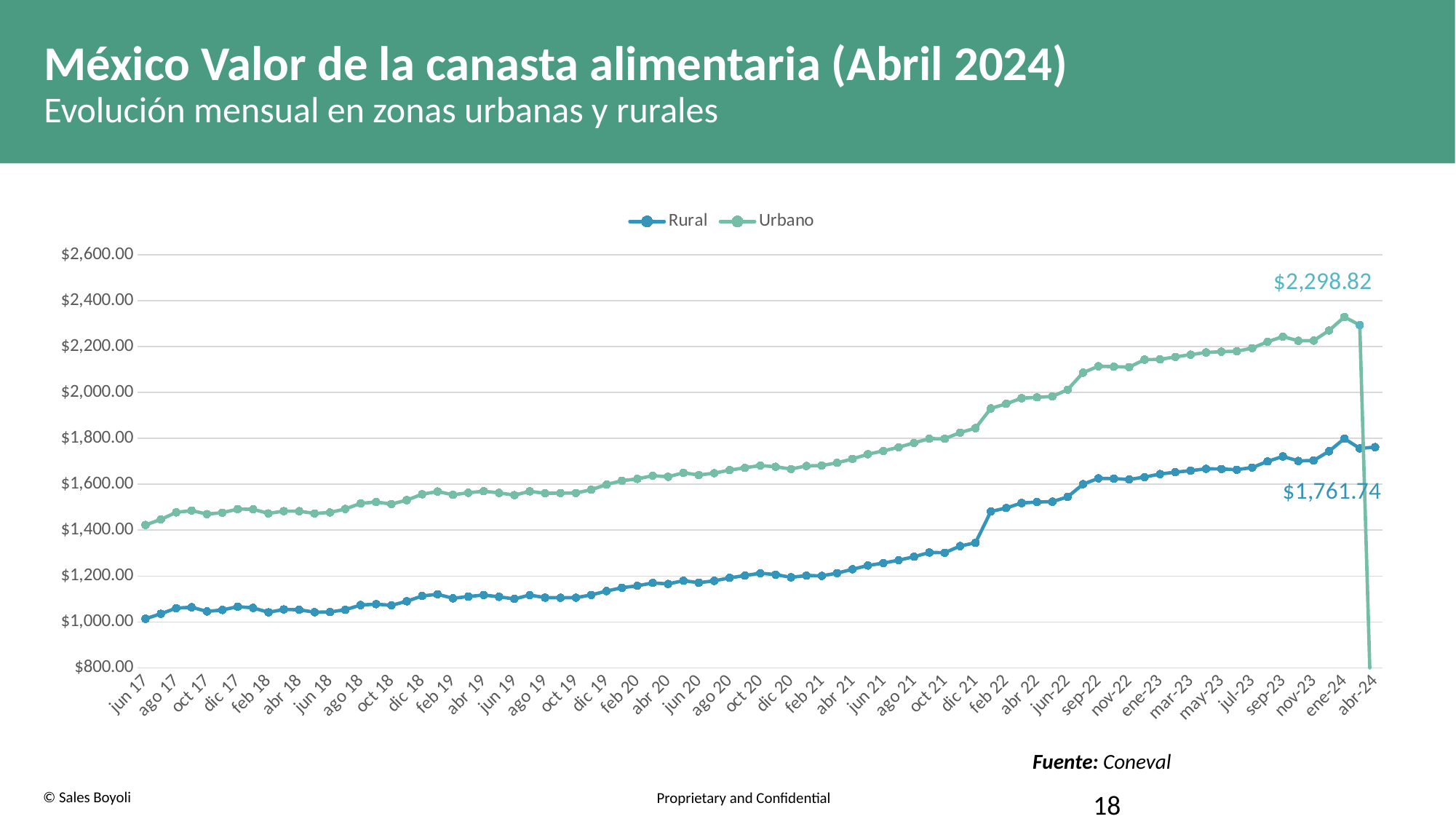
What kind of chart is shown on the slide? line chart Is the Rural value for feb 22 greater or less than $1,400.00? greater What is the difference between the labelled Urbano value ($2,298.82) and the labelled Rural value ($1,761.74)? $537.08 Do the Rural values generally rise or fall from jun 17 to ene-24? rise Is the Urbano value for sep-22 greater or less than $2,000.00? greater What are the two series named in the legend? Rural and Urbano Is the Rural value for dic 21 greater or less than $1,400.00? less What value is printed as the data label for the Urbano series? $2,298.82 How many series does the legend list? 2 Which series has higher values throughout the period, Rural or Urbano? Urbano What value is printed as the data label for the Rural series? $1,761.74 What is the title of the slide containing the chart? México Valor de la canasta alimentaria (Abril 2024)